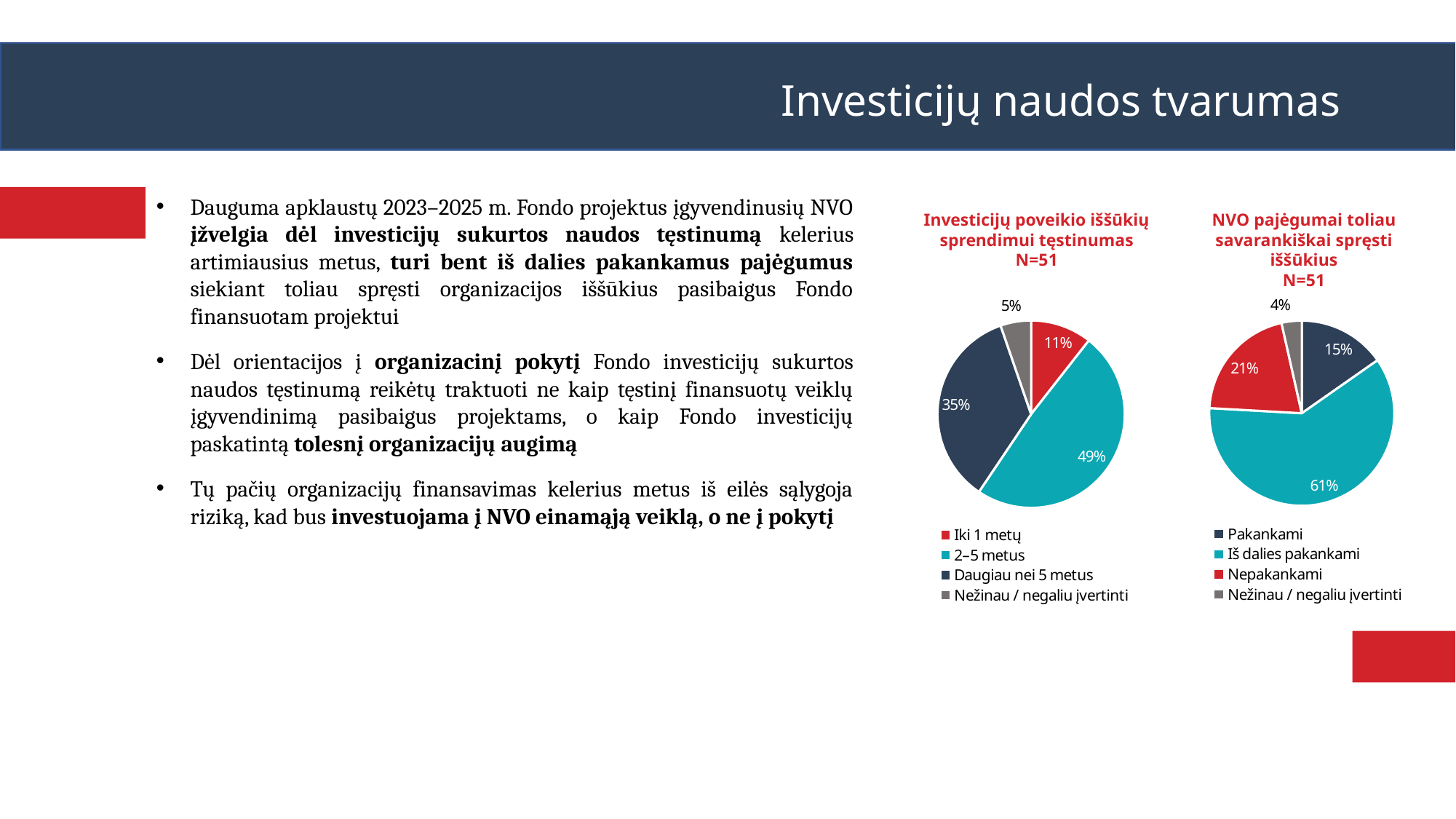
How many slices does the left pie chart (Investicijų poveikio iššūkių sprendimui tęstinumas) have? 4 In the right pie chart (NVO pajėgumai toliau savarankiškai spręsti iššūkius), what share is labelled for 'Nepakankami'? 21% In the left pie chart (Investicijų poveikio iššūkių sprendimui tęstinumas), what share is labelled for 'Daugiau nei 5 metus'? 35% In the left pie chart (Investicijų poveikio iššūkių sprendimui tęstinumas), which category has the smallest share? Nežinau / negaliu įvertinti In the right pie chart (NVO pajėgumai toliau savarankiškai spręsti iššūkius), what is the difference between the shares for 'Iš dalies pakankami' and 'Pakankami'? 46 percentage points What sample size (N) is stated in the title of the left pie chart? N=51 In the right pie chart (NVO pajėgumai toliau savarankiškai spręsti iššūkius), which is larger: the share for 'Pakankami' or for 'Nepakankami'? Nepakankami What type of chart is used for 'NVO pajėgumai toliau savarankiškai spręsti iššūkius'? Pie chart In the left pie chart (Investicijų poveikio iššūkių sprendimui tęstinumas), what share is labelled for '2–5 metus'? 49% In the right pie chart (NVO pajėgumai toliau savarankiškai spręsti iššūkius), which category has the largest share? Iš dalies pakankami In the left pie chart (Investicijų poveikio iššūkių sprendimui tęstinumas), what is the difference between the shares for '2–5 metus' and 'Iki 1 metų'? 38 percentage points